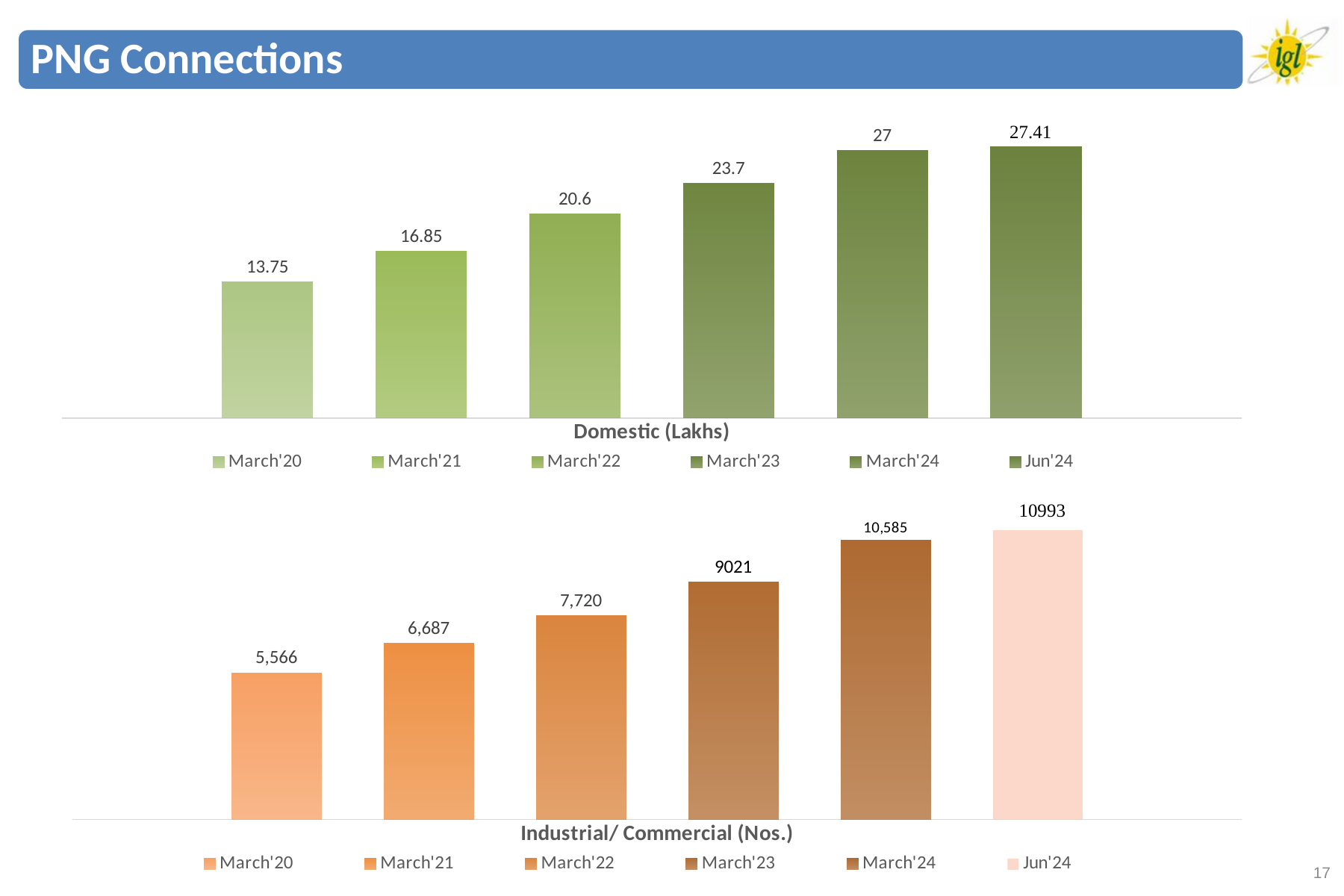
In the Domestic (Lakhs) chart, which is larger, the value for March'21 or March'23? March'23 In the Industrial/ Commercial (Nos.) chart, what is the difference between the Jun'24 and March'24 values? 408 In the Domestic (Lakhs) chart, what is the value for March'22? 20.6 In the Industrial/ Commercial (Nos.) chart, what is the value for March'24? 10,585 How many entries does the legend of the Domestic (Lakhs) chart list? 6 In the Industrial/ Commercial (Nos.) chart, do the values rise or fall from March'20 to Jun'24? Rise What type of chart is the Domestic (Lakhs) chart? Bar chart In the Domestic (Lakhs) chart, which period has the lowest value? March'20 In the Domestic (Lakhs) chart, what is the difference between the Jun'24 and March'24 values? 0.41 What is the title of the slide? PNG Connections In the Industrial/ Commercial (Nos.) chart, which period has the highest value? Jun'24 How many bars are shown in the Industrial/ Commercial (Nos.) chart? 6